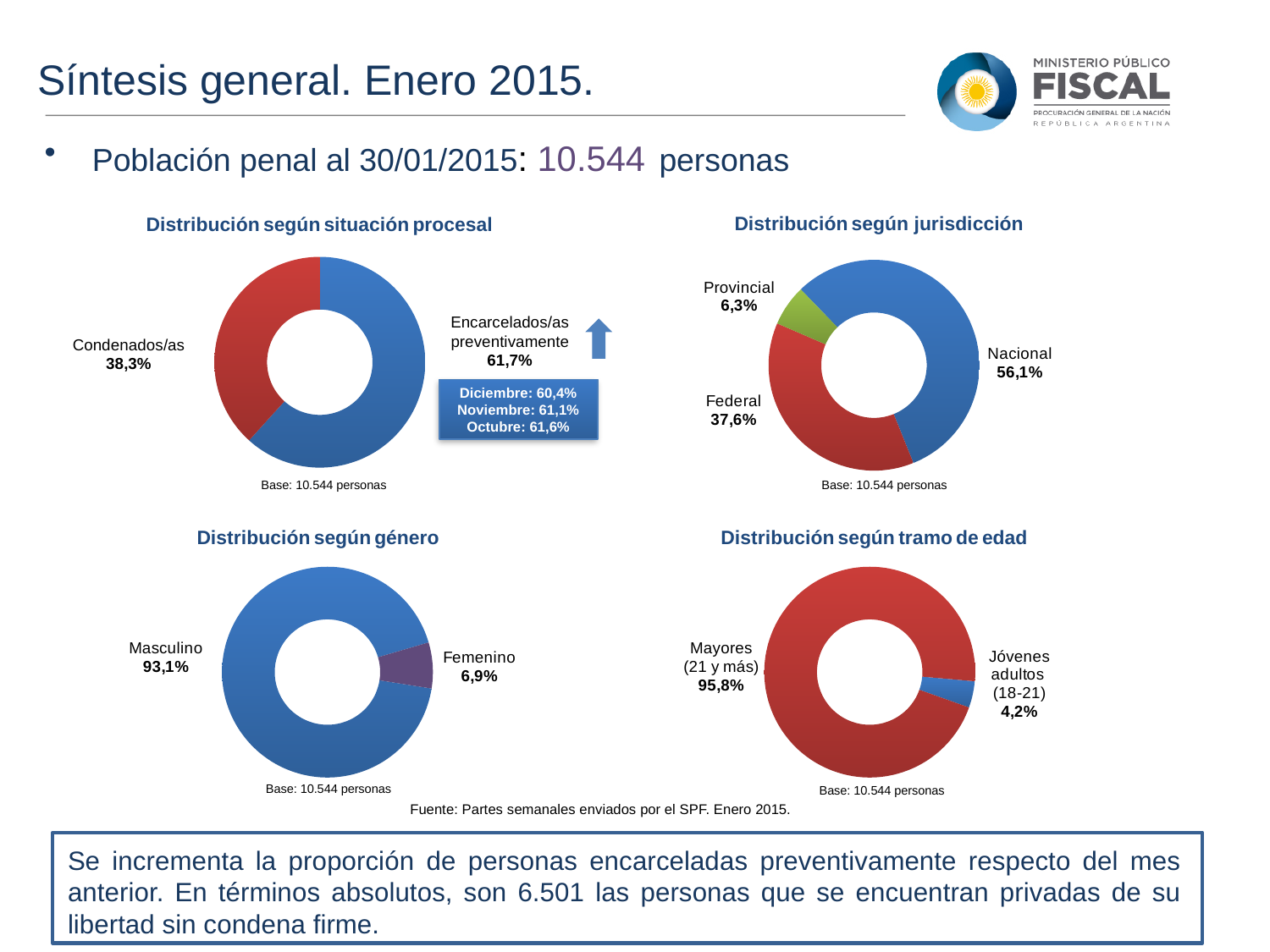
In the 'Distribución según jurisdicción' chart, which category has the smallest share? Provincial In the 'Distribución según situación procesal' chart, what is the share for Condenados/as? 38,3% In the 'Distribución según género' chart, what is the difference between the Masculino and Femenino shares? 86,2% In the 'Distribución según jurisdicción' chart, what is the share for Federal? 37,6% In the 'Distribución según jurisdicción' chart, which category has the largest share? Nacional In the 'Distribución según género' chart, what is the share for Femenino? 6,9% In the 'Distribución según tramo de edad' chart, which is larger, Mayores (21 y más) or Jóvenes adultos (18-21)? Mayores (21 y más) In the 'Distribución según situación procesal' chart, what is the share for Encarcelados/as preventivamente? 61,7% In the 'Distribución según jurisdicción' chart, what is the difference between the Nacional and Federal shares? 18,5% What kind of chart is 'Distribución según género'? Pie chart (donut) In the 'Distribución según jurisdicción' chart, how many categories are shown? 3 In the 'Distribución según tramo de edad' chart, what is the share for Jóvenes adultos (18-21)? 4,2%